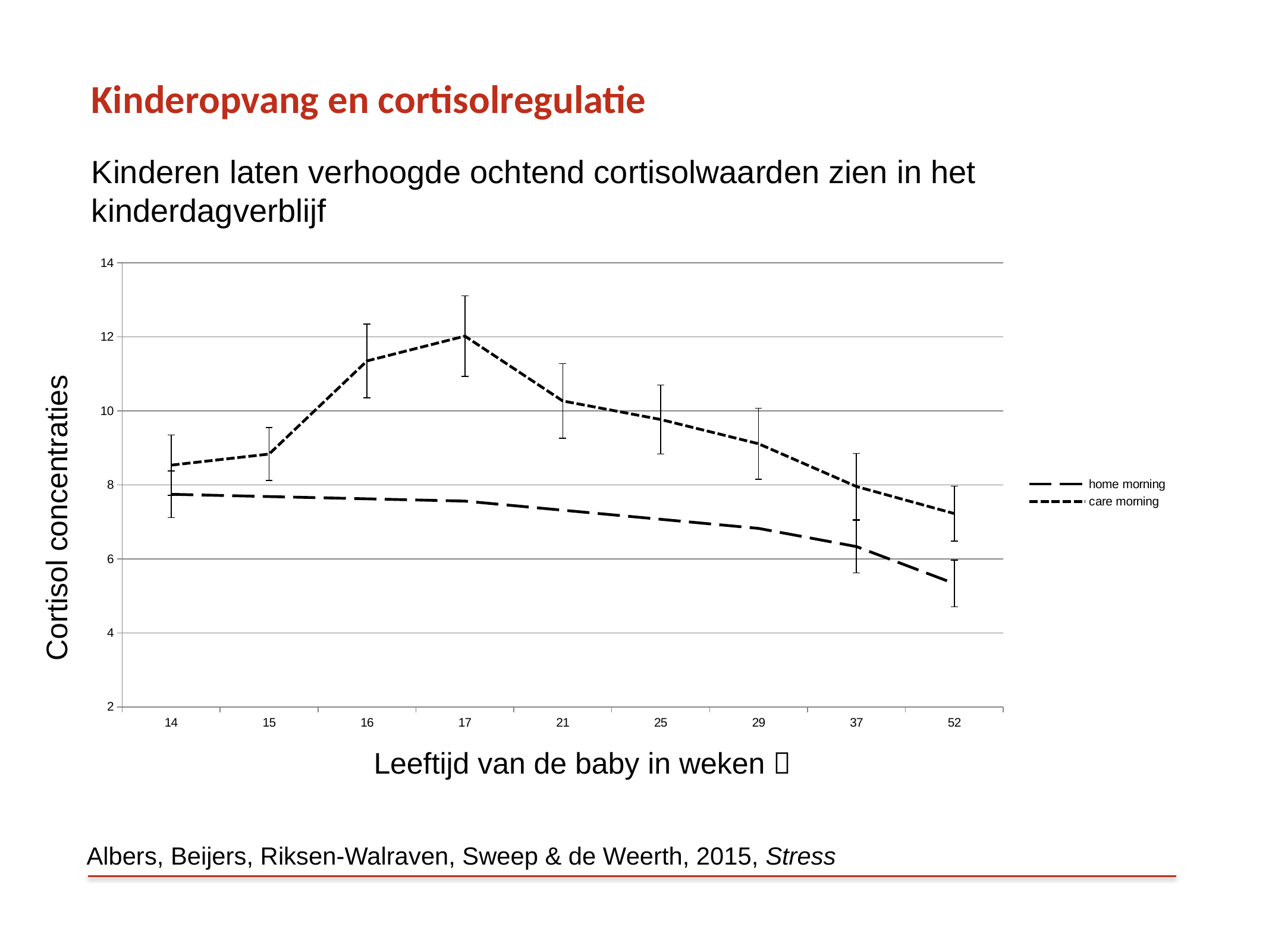
What kind of chart is shown on the slide? line chart How many series does the legend list? 2 Is the home morning value at 52 weeks greater or less than 6? less Is the care morning value at 17 weeks greater or less than 10? greater At which age in weeks does the care morning series reach its highest value? 17 At 17 weeks, which series has the higher value, home morning or care morning? care morning How many age points (in weeks) are shown along the x axis? 9 Does the home morning series rise or fall as the baby's age in weeks increases? fall Is the care morning value at 14 weeks greater or less than 8? greater At which age in weeks does the home morning series reach its lowest value? 52 What is the label of the y axis? Cortisol concentraties At which age in weeks does the care morning series reach its lowest value? 52